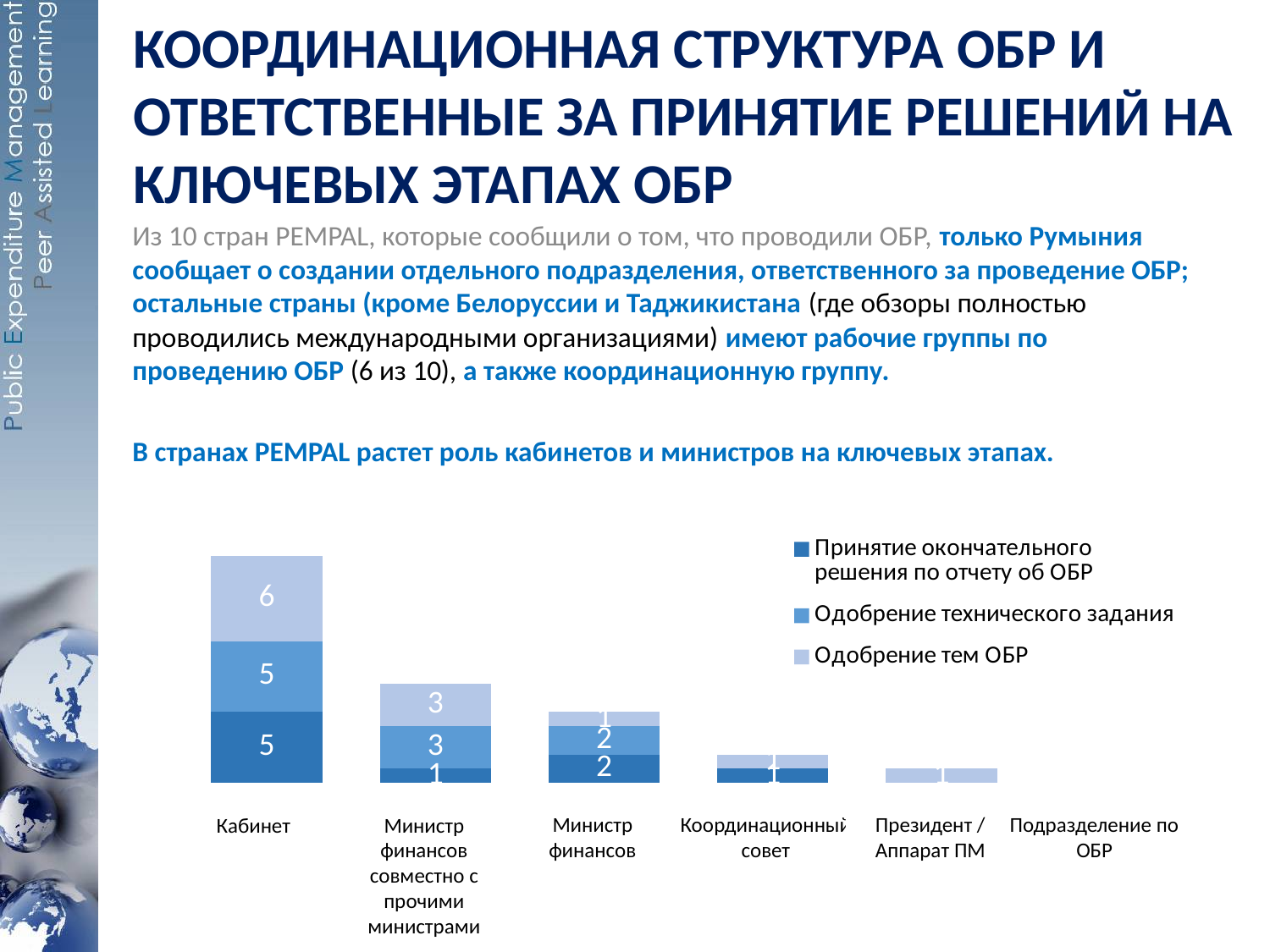
What is the total of the stacked bar for 'Министр финансов совместно с прочими министрами'? 7 What is the value of 'Принятие окончательного решения по отчету об ОБР' for 'Министр финансов'? 2 What is the total of the stacked bar for 'Кабинет'? 16 What is the value of 'Одобрение технического задания' for 'Министр финансов совместно с прочими министрами'? 3 Which category has the tallest stacked bar? Кабинет What is the value of 'Одобрение тем ОБР' for 'Кабинет'? 6 What is the difference between the 'Принятие окончательного решения по отчету об ОБР' values for 'Кабинет' and 'Министр финансов'? 3 Which is larger: the 'Принятие окончательного решения по отчету об ОБР' value for 'Кабинет' or for 'Министр финансов'? Кабинет What is the value of 'Принятие окончательного решения по отчету об ОБР' for 'Кабинет'? 5 How many series does the chart legend list? 3 What kind of chart is shown on the slide? Stacked bar chart How many categories are shown along the x axis of the chart? 6